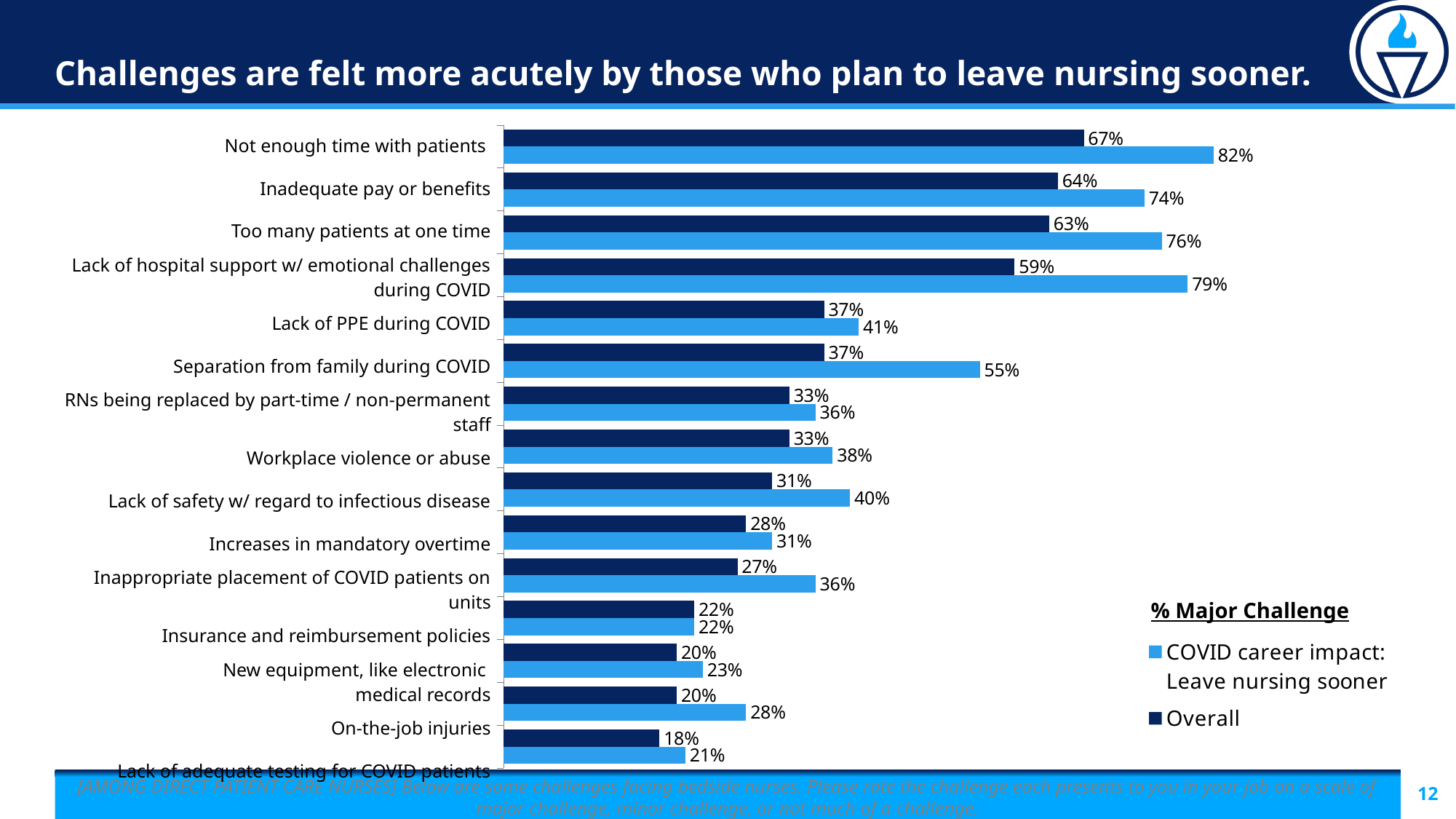
How many categories are shown on the chart? 15 What is the difference between the 'Leave nursing sooner' and Overall values for 'Separation from family during COVID'? 18% What is the heading shown above the legend? % Major Challenge What is the Overall value for 'Not enough time with patients'? 67% What is the 'COVID career impact: Leave nursing sooner' value for 'Not enough time with patients'? 82% What is the 'COVID career impact: Leave nursing sooner' value for 'Lack of hospital support w/ emotional challenges during COVID'? 79% What type of chart is shown on the slide? bar chart Which is larger for 'Lack of PPE during COVID': the Overall value or the 'Leave nursing sooner' value? Leave nursing sooner Which category has the highest Overall value? Not enough time with patients How many series does the legend list? 2 What is the Overall value for 'Inadequate pay or benefits'? 64% What is the difference between the 'Leave nursing sooner' and Overall values for 'Too many patients at one time'? 13%